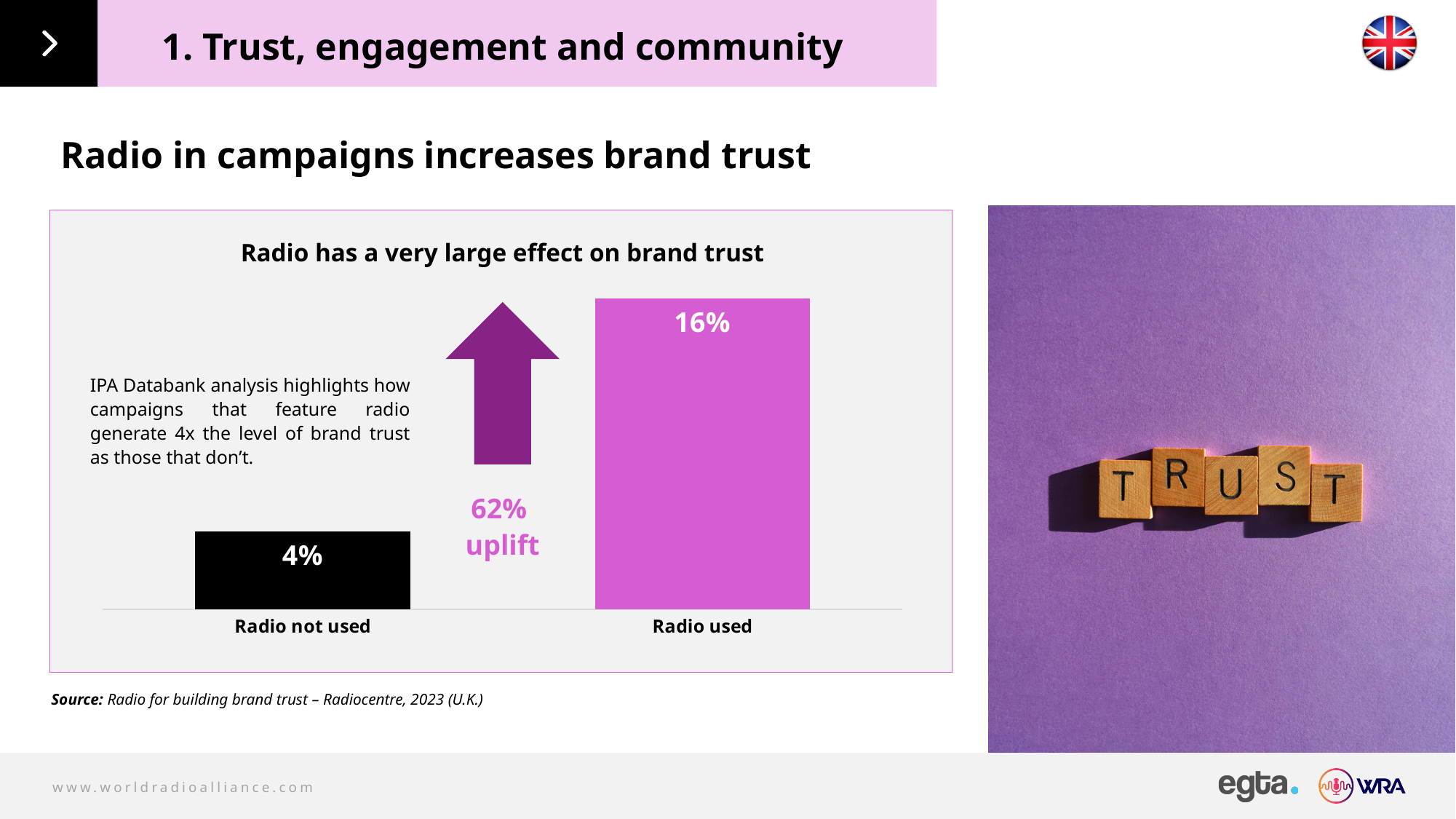
What is the value for Radio not used? 4% Which is larger, the value for Radio used or Radio not used? Radio used What is the title of the chart? Radio has a very large effect on brand trust What uplift is annotated between the two bars? 62% uplift Which category has the lowest value? Radio not used What is the difference between the values for Radio used and Radio not used? 12% What kind of chart is shown on the slide? Bar chart What is the value for Radio used? 16% How many categories are shown in the chart? 2 Which category has the highest value? Radio used